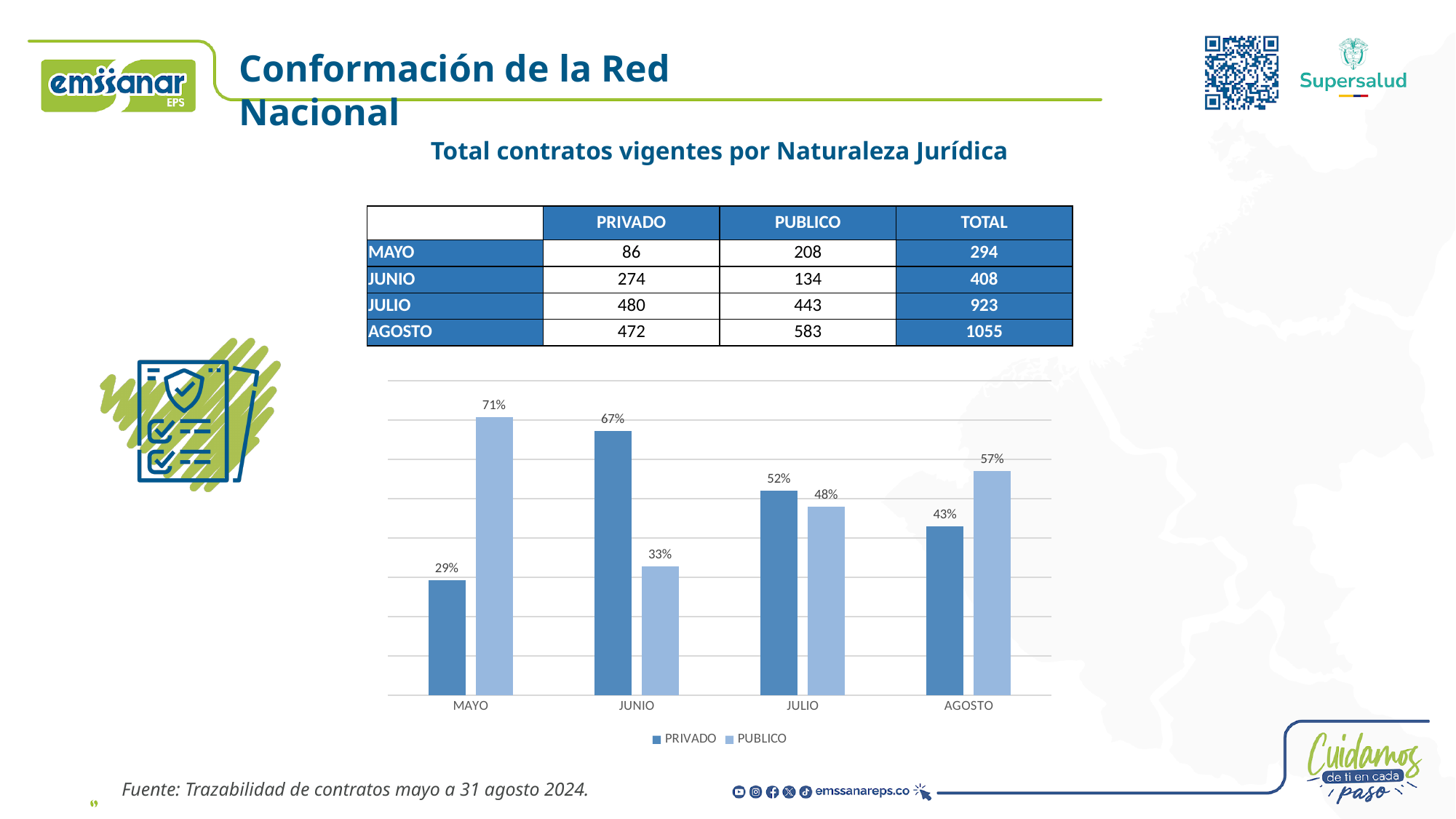
What kind of chart is shown on the slide? Bar chart How many series does the chart legend list? 2 Which month has the highest PRIVADO value in the chart? JUNIO What is the PRIVADO value for MAYO in the chart? 29% What is the difference between the PUBLICO and PRIVADO values for MAYO in the chart? 42% Which series in the chart is shown in the lighter blue colour? PUBLICO In the chart, which is larger for JULIO: PRIVADO or PUBLICO? PRIVADO How many months are shown on the x axis of the chart? 4 Which month has the lowest PUBLICO value in the chart? JUNIO Does the PRIVADO value rise or fall from JUNIO to AGOSTO in the chart? Fall What is the PUBLICO value for AGOSTO in the chart? 57% What is the PUBLICO value for JUNIO in the chart? 33%